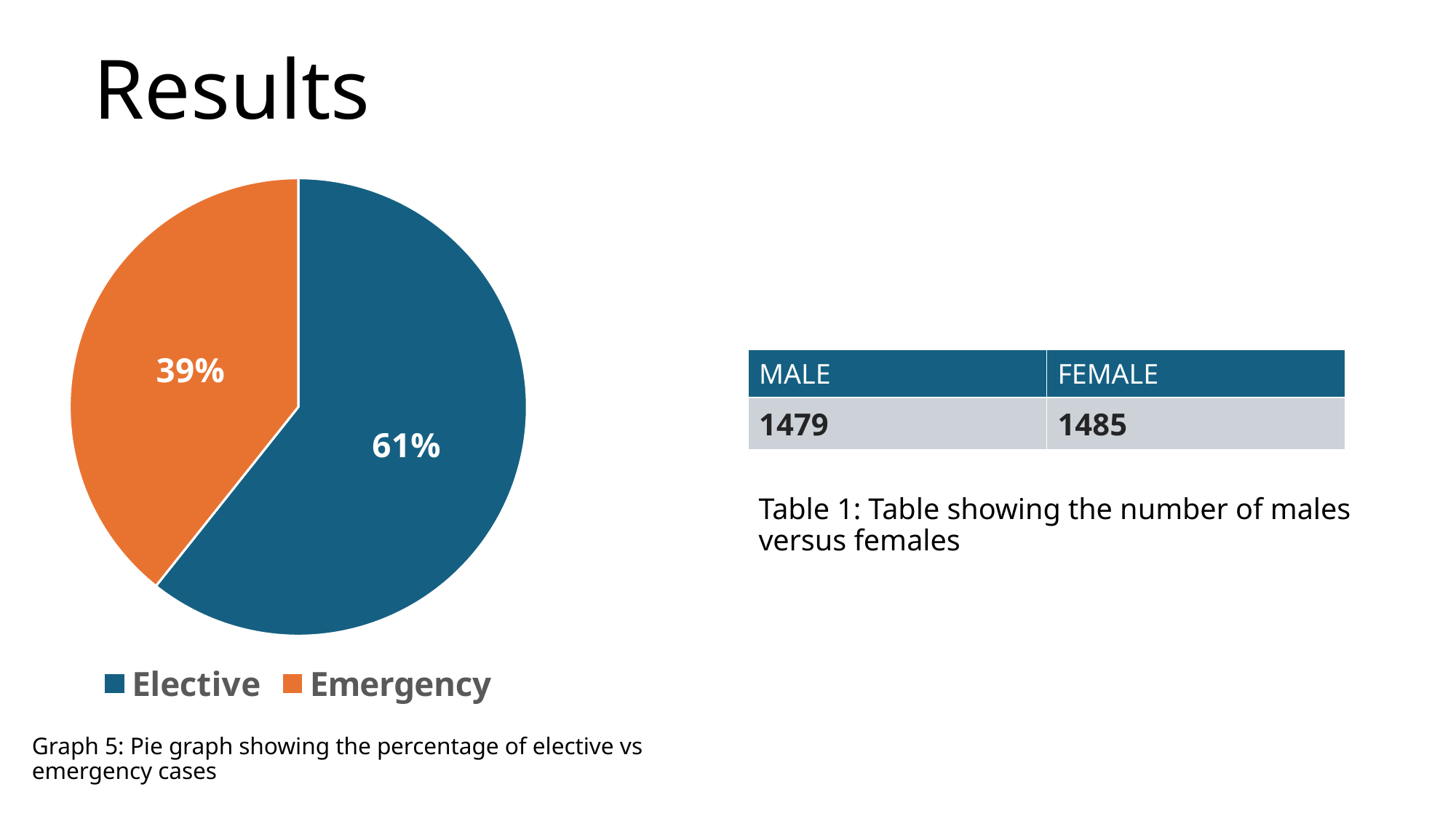
Which category has the largest share of the pie chart? Elective Which category has the smallest share of the pie chart? Emergency Which slice is larger, Elective or Emergency? Elective What percentage of cases are Emergency in the pie chart? 39% What colour is the Emergency slice in the pie chart? Orange What share of the pie does the Emergency slice represent? 39% What colour is the Elective slice in the pie chart? Blue What percentage of cases are Elective in the pie chart? 61% How many slices does the pie chart have? 2 What is the difference in percentage points between the Elective and Emergency slices? 22 How many entries does the pie chart legend list? 2 What kind of chart is shown on the slide? Pie chart